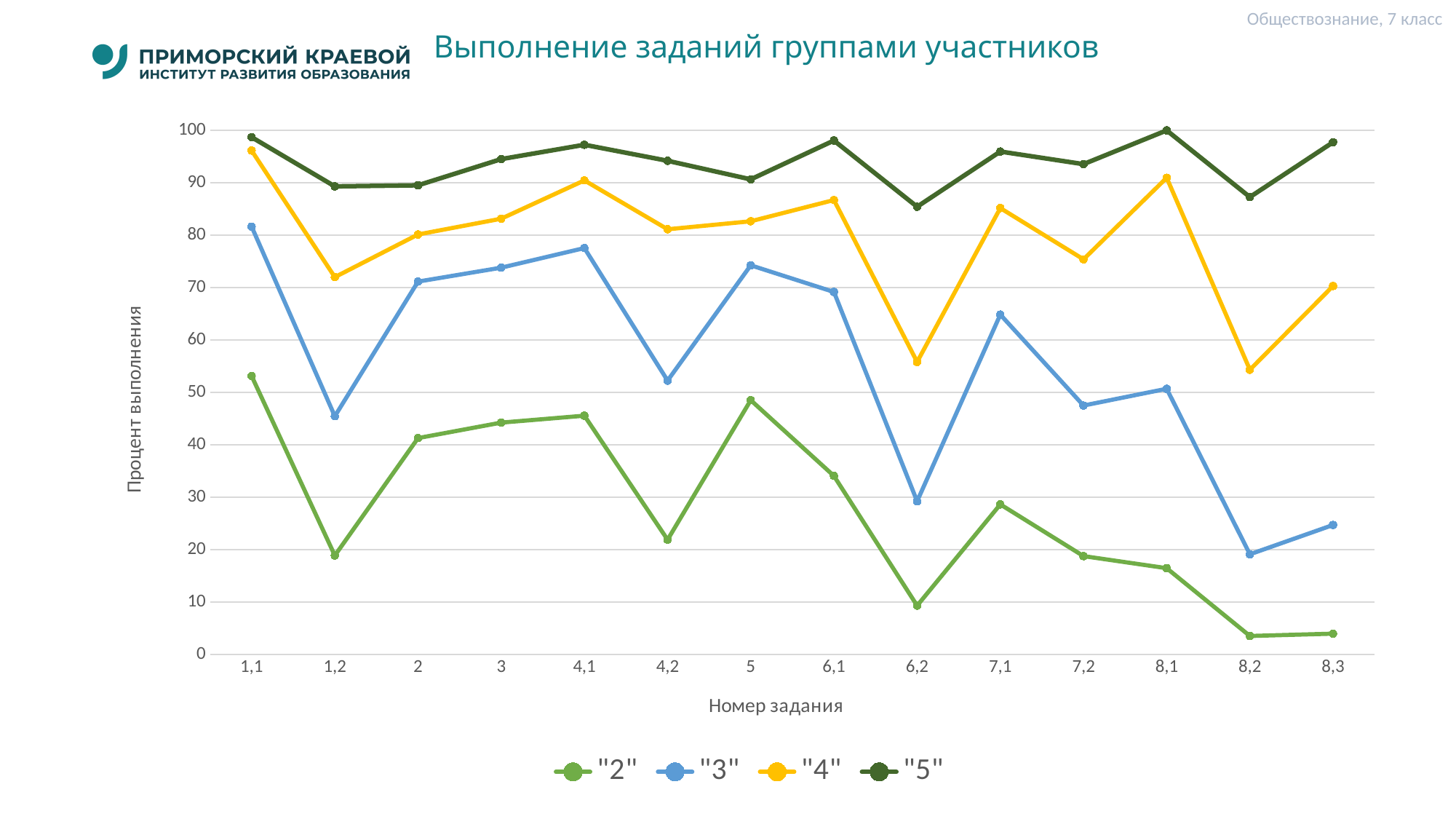
Is the value for series "5" at task 6,2 greater or less than 80? greater Does the line for series "2" rise or fall from task 7,1 to task 8,2? fall At task 1,2, which series has the larger value, "2" or "3"? "3" How many series does the legend list? 4 What kind of chart is shown on the slide? line chart For series "2", at which task number is the value highest? 1,1 For series "4", at which task number is the value highest? 1,1 Is the value for series "3" at task 4,2 greater or less than 60? less For series "3", at which task number is the value lowest? 8,2 What is the title of the vertical axis? Процент выполнения How many task numbers are shown along the x axis? 14 Is the value for series "2" at task 8,2 greater or less than 10? less